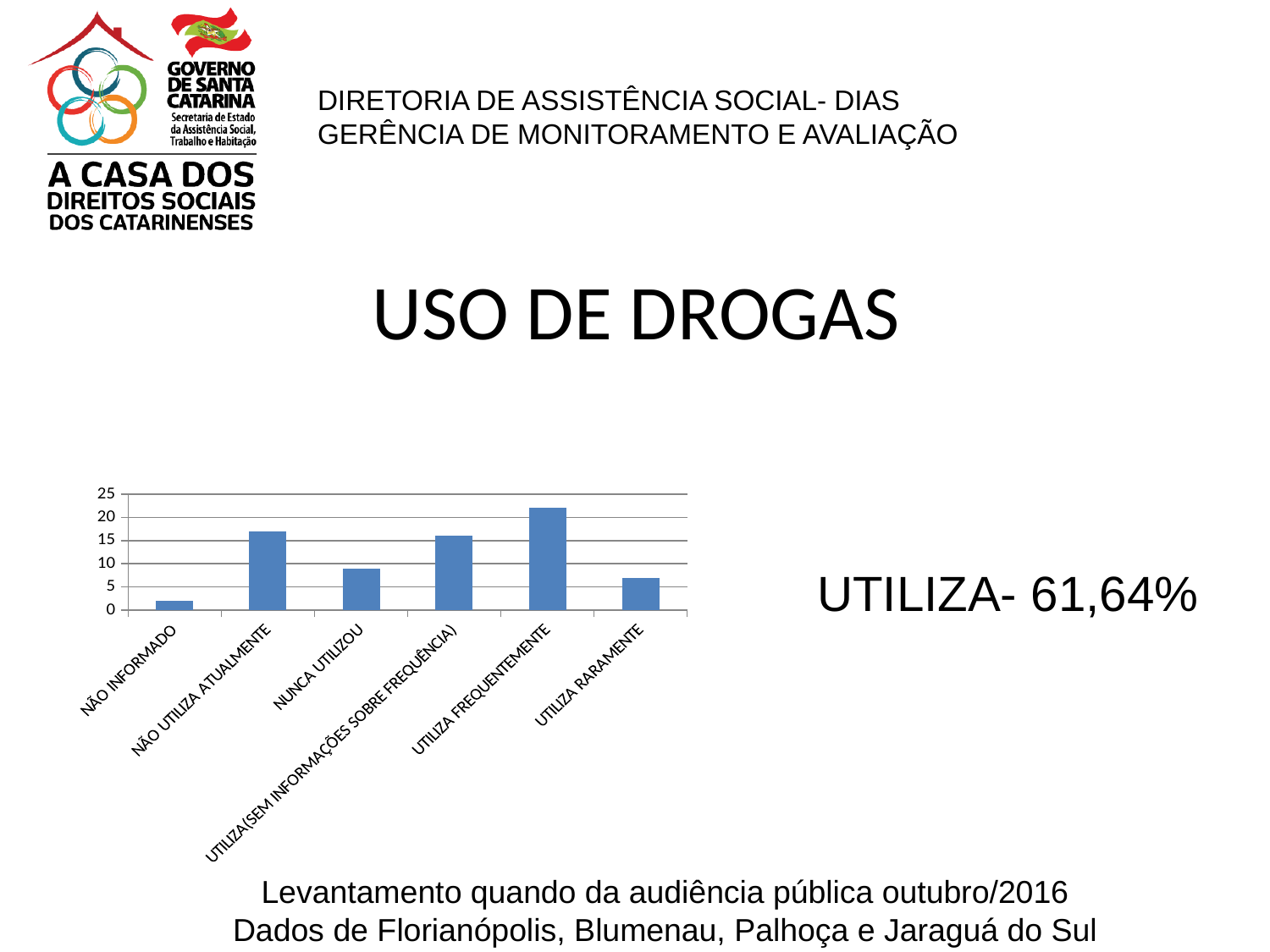
Is the value for NÃO INFORMADO greater or less than 5? less How many categories are shown on the x axis of the chart? 6 Is the value for NÃO UTILIZA ATUALMENTE greater or less than 15? greater Is the value for UTILIZA (SEM INFORMAÇÕES SOBRE FREQUÊNCIA) greater or less than 10? greater What kind of chart is shown on the slide? bar chart What is the title shown above the chart on the slide? USO DE DROGAS Which category has the lowest bar in the chart? NÃO INFORMADO What percentage is given next to the chart for UTILIZA? 61,64% Which is larger, the value for NÃO UTILIZA ATUALMENTE or the value for NUNCA UTILIZOU? NÃO UTILIZA ATUALMENTE Which category has the highest bar in the chart? UTILIZA FREQUENTEMENTE